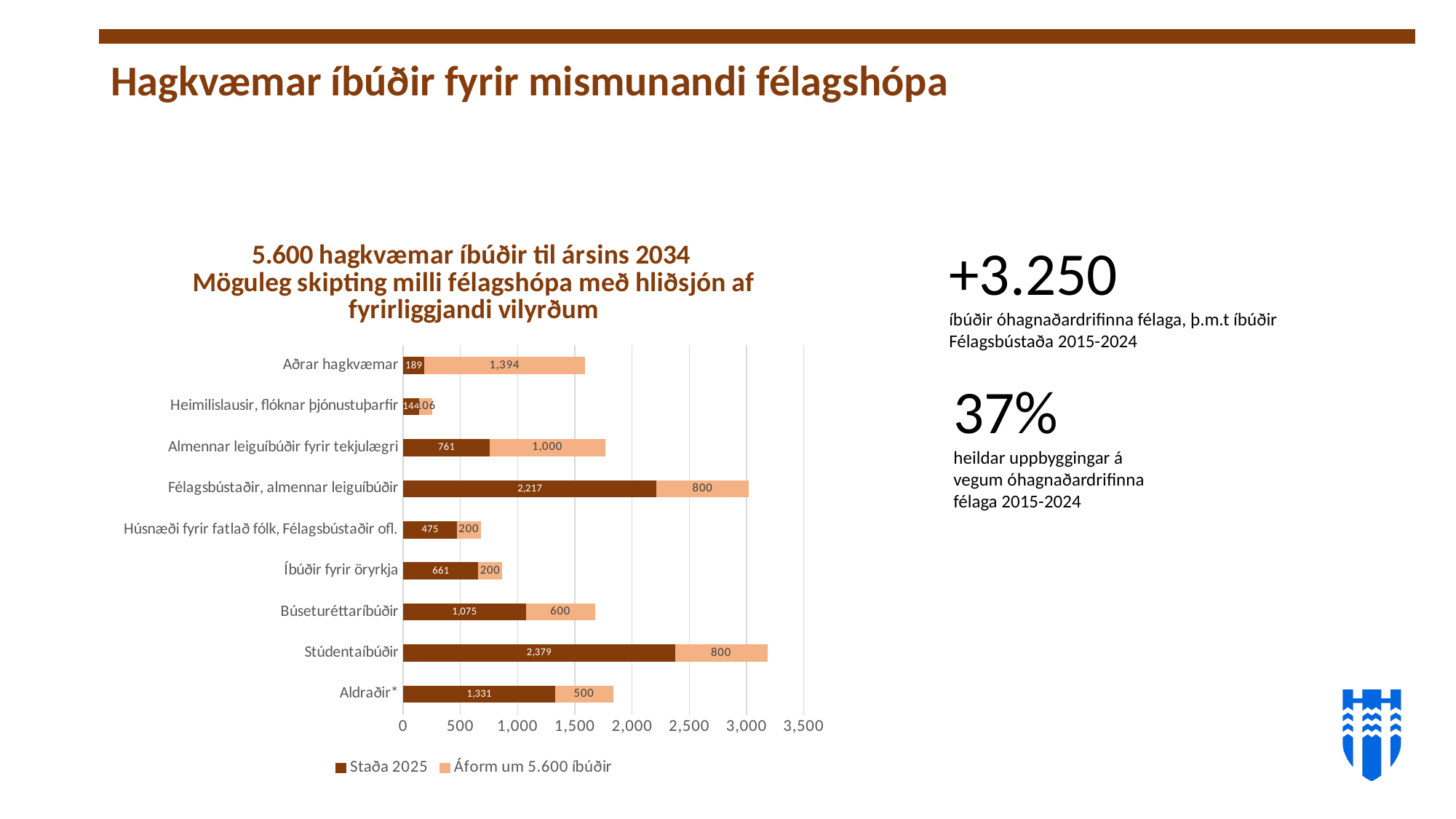
Which is larger: the Staða 2025 value for Aldraðir* or for Búseturéttaríbúðir? Aldraðir* Which category has the highest Staða 2025 value? Stúdentaíbúðir What is the difference between the Staða 2025 values for Stúdentaíbúðir and Félagsbústaðir, almennar leiguíbúðir? 162 What type of chart is shown on the slide? Stacked bar chart What is the title of the chart? 5.600 hagkvæmar íbúðir til ársins 2034 Möguleg skipting milli félagshópa með hliðsjón af fyrirliggjandi vilyrðum How many series does the chart legend list? 2 What is the Áform um 5.600 íbúðir value for Aðrar hagkvæmar? 1,394 How many categories are shown on the chart? 9 What is the Staða 2025 value for Búseturéttaríbúðir? 1,075 Which category has the lowest Staða 2025 value? Heimilislausir, flóknar þjónustuþarfir What is the Staða 2025 value for Stúdentaíbúðir? 2,379 What is the total of the stacked bar for Stúdentaíbúðir? 3,179